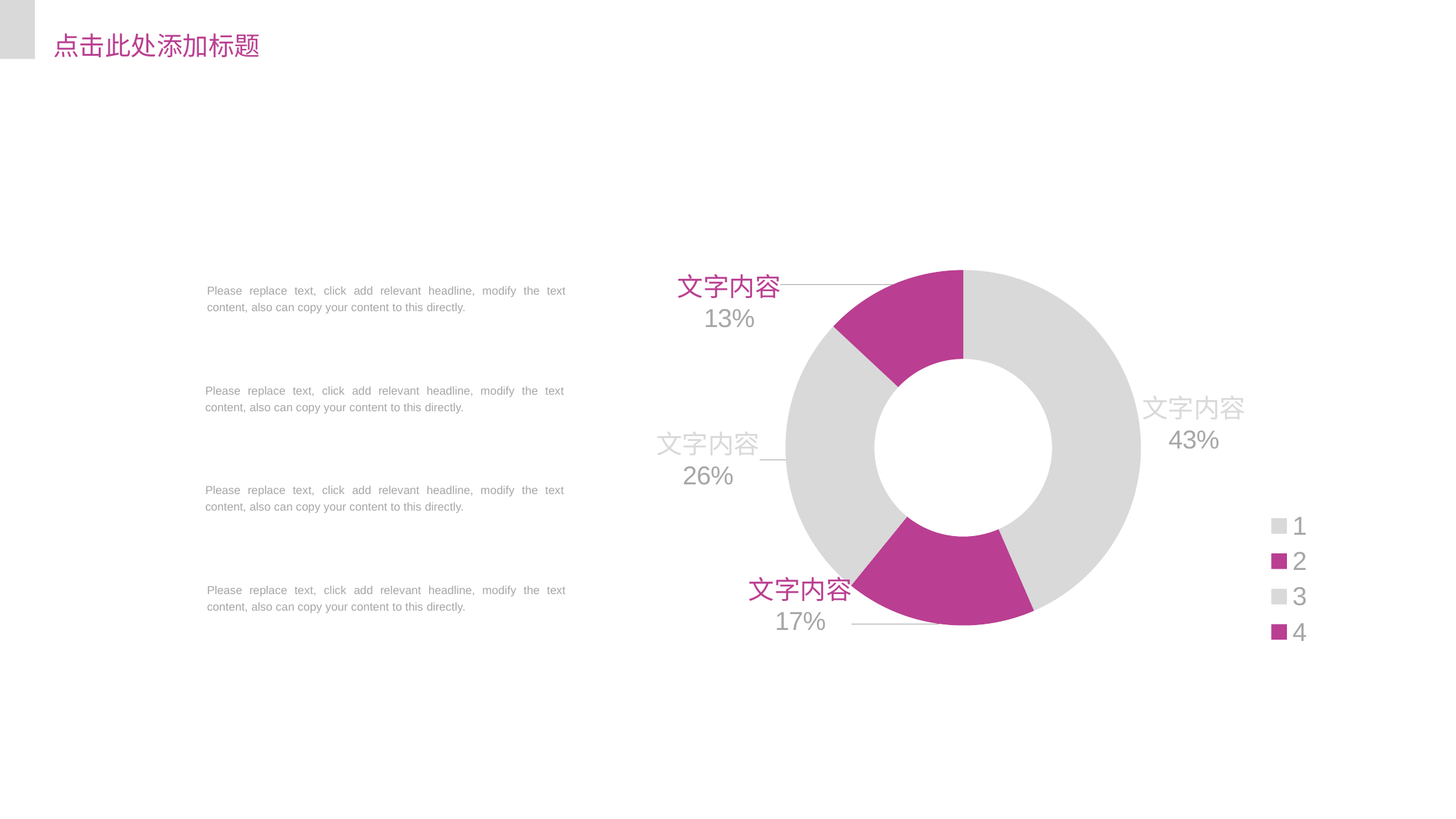
What colour are the slices for legend entries 2 and 4? magenta What kind of chart is shown on the slide? doughnut chart What percentage is shown for legend entry 3 (the gray slice on the left)? 26% What percentage is shown for legend entry 1 (the largest gray slice)? 43% Which slice has the largest share of the doughnut chart? 43% How many entries does the legend list? 4 Which is larger, the slice labelled 26% or the slice labelled 17%? 26% What percentage is shown for legend entry 4 (the magenta slice at the top left)? 13% How many slices does the doughnut chart have? 4 What percentage is shown for legend entry 2 (the magenta slice at the bottom)? 17% What is the difference between the largest slice (43%) and the smallest slice (13%)? 30% Which slice has the smallest share of the doughnut chart? 13%